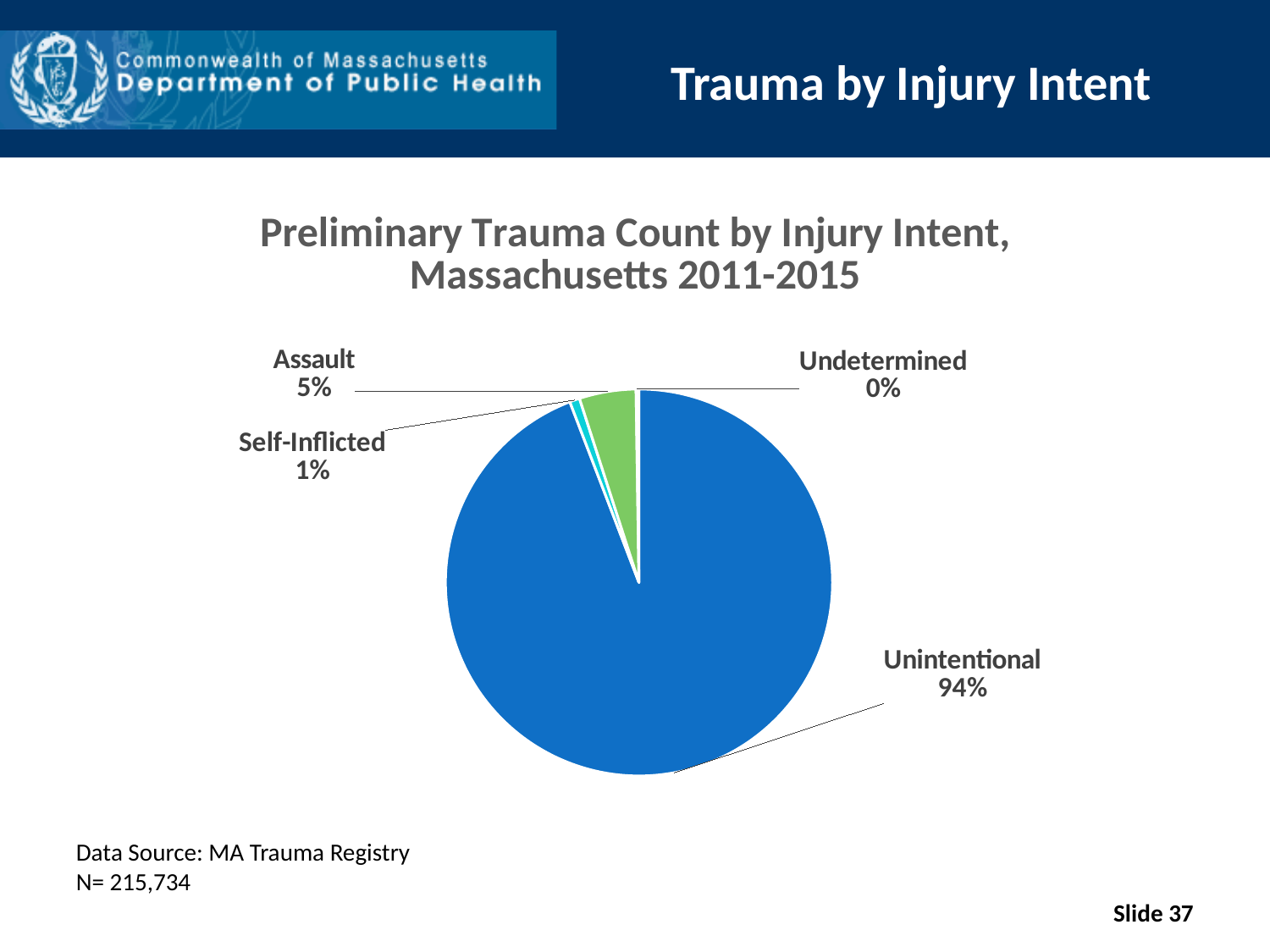
What share of the pie does Unintentional represent? 94% What is the title of the chart? Preliminary Trauma Count by Injury Intent, Massachusetts 2011-2015 Which injury intent category has the largest slice? Unintentional How many categories are shown in the pie chart? 4 What is the value shown for Assault? 5% What is the value shown for Undetermined? 0% Which is larger, Assault or Self-Inflicted? Assault What is the N value stated below the chart? 215,734 What kind of chart is shown on the slide? Pie chart Which injury intent category has the smallest slice? Undetermined What is the value shown for Self-Inflicted? 1% What is the difference in percentage points between Unintentional and Assault? 89